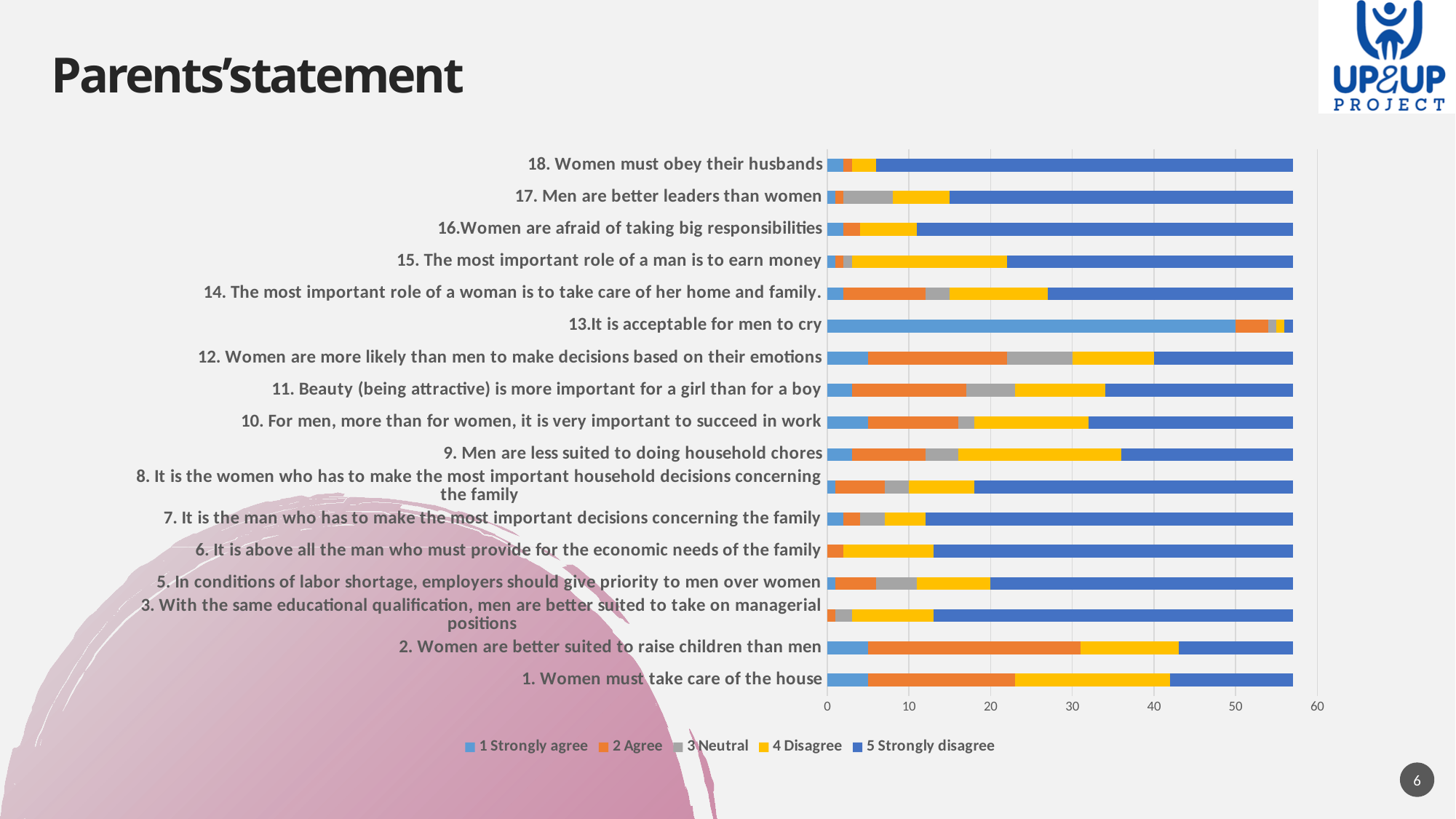
Which statement has the largest '1 Strongly agree' segment? 13.It is acceptable for men to cry Is the '1 Strongly agree' value for '13.It is acceptable for men to cry' greater or less than 40? greater Which statement has the smallest '5 Strongly disagree' segment? 13.It is acceptable for men to cry Which statement has the largest '5 Strongly disagree' segment? 18. Women must obey their husbands What kind of chart is shown on the slide? Stacked bar chart How many series does the legend list? 5 Which has the larger '1 Strongly agree' value: '13.It is acceptable for men to cry' or '18. Women must obey their husbands'? 13.It is acceptable for men to cry Is the '2 Agree' value for '2. Women are better suited to raise children than men' greater or less than 20? greater Which legend entry is shown in orange? 2 Agree How many statements (categories) are plotted on the chart? 17 Is the '5 Strongly disagree' value for '13.It is acceptable for men to cry' greater or less than 10? less What is the title of the slide containing the chart? Parents'statement